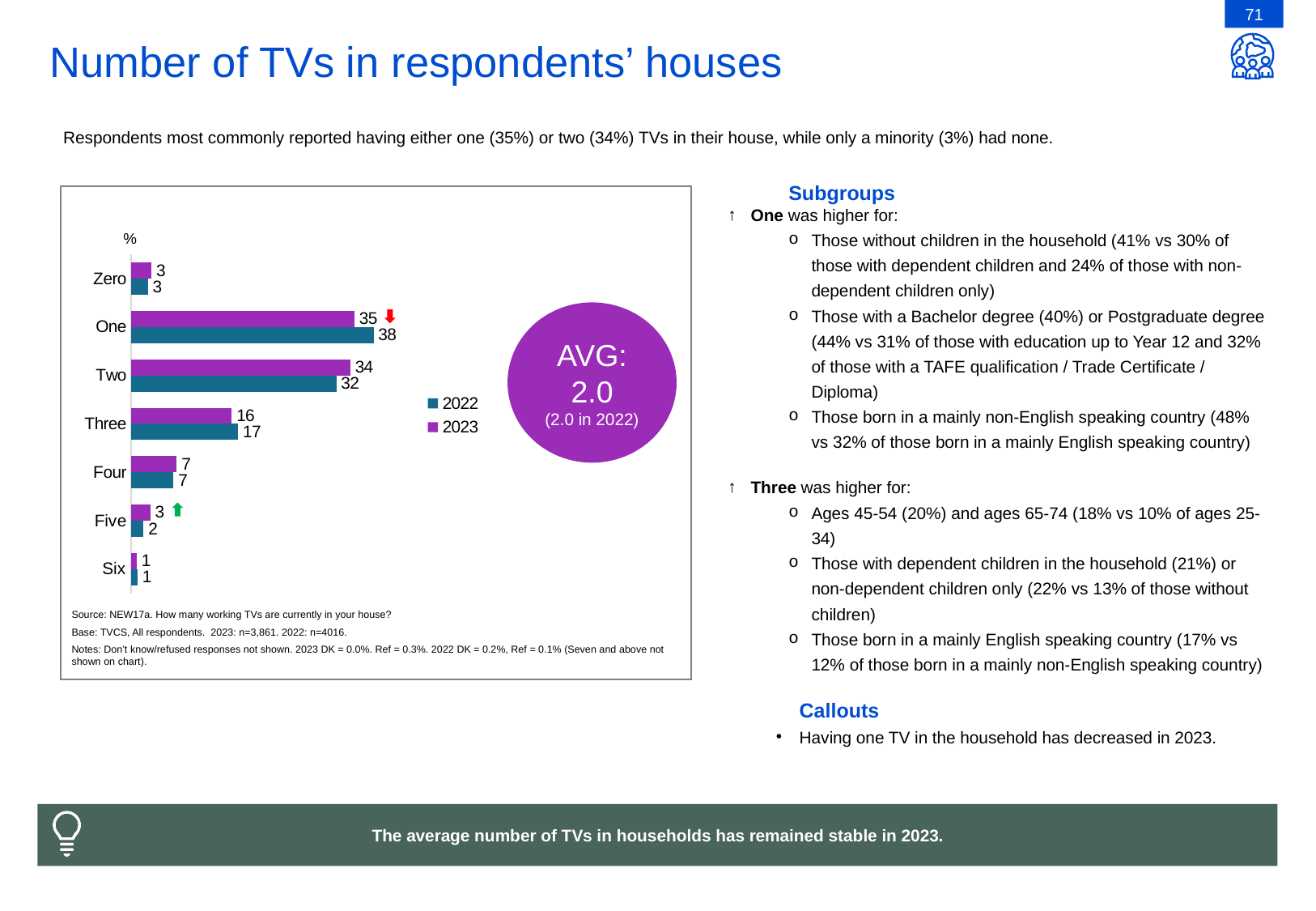
Which is larger for Two: the 2022 value or the 2023 value? 2023 What kind of chart is shown? Bar chart What is the 2022 value for One? 38 What is the 2023 value for Two? 34 What is the 2022 value for Three? 17 What is the 2023 value for One? 35 Which category has the highest 2023 value? One What is the difference between the 2022 and 2023 values for One? 3 How many series does the legend list? 2 What average value is shown in the circle on the chart? 2.0 How many categories are shown on the chart? 7 Which category has the lowest 2022 value? Six